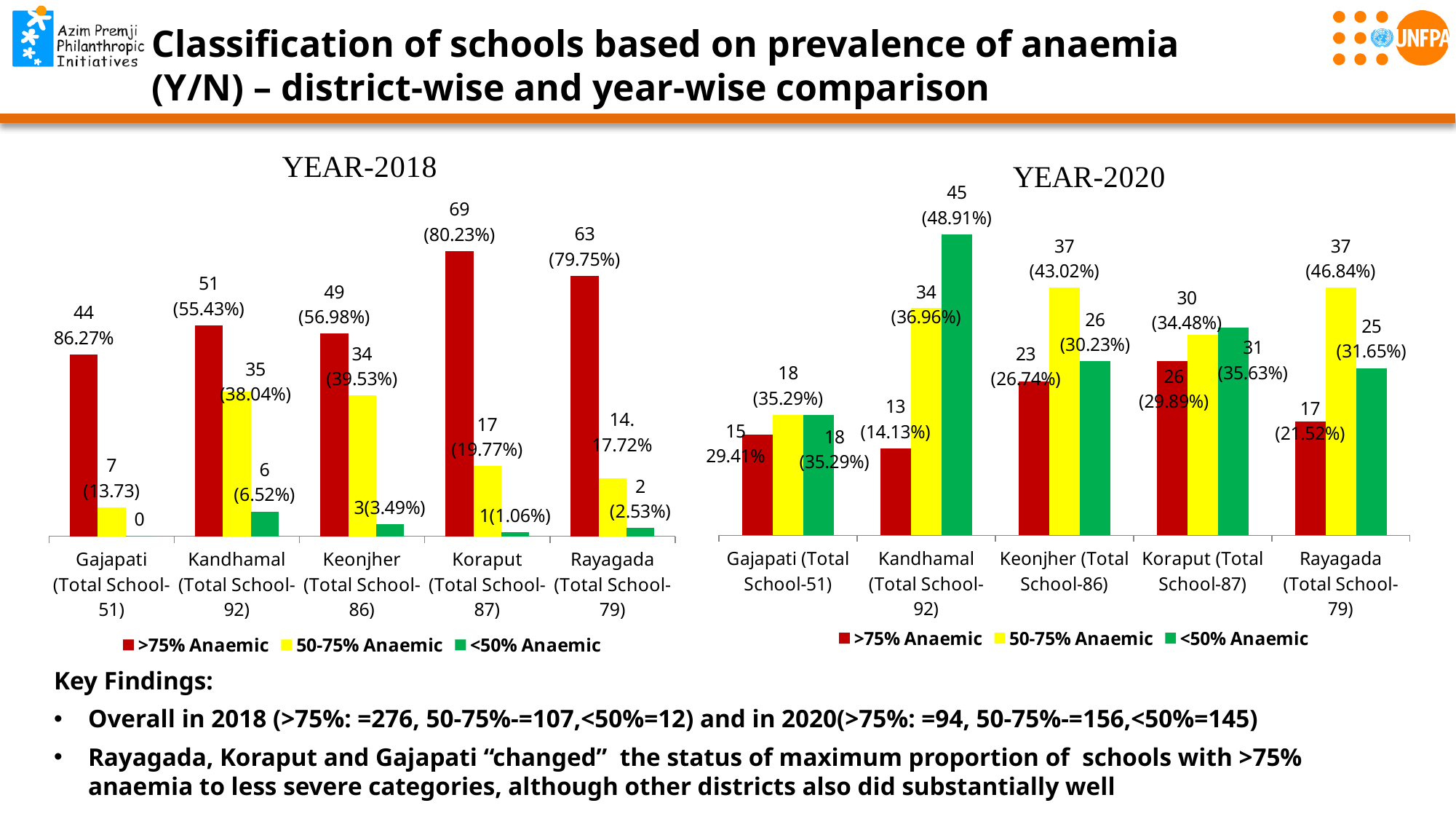
In the YEAR-2018 chart, which district has the highest number of schools in the >75% Anaemic category? Koraput Which colour represents the <50% Anaemic series in the legends of both charts? Green In the YEAR-2018 chart, what percentage is shown for Gajapati in the >75% Anaemic category? 86.27% In the YEAR-2020 chart, what is the total number of schools across the three categories for Rayagada? 79 In the YEAR-2020 chart, how many schools in Kandhamal are in the <50% Anaemic category? 45 In the YEAR-2018 chart, how many schools in Koraput are in the >75% Anaemic category? 69 In the YEAR-2018 chart, what is the difference between the >75% Anaemic and 50-75% Anaemic school counts for Kandhamal? 16 What type of chart is the YEAR-2018 chart? Bar chart In the YEAR-2020 chart, which district has the lowest number of schools in the >75% Anaemic category? Kandhamal How many districts are shown on the x axis of the YEAR-2020 chart? 5 In the YEAR-2020 chart, which is larger for Keonjher: the 50-75% Anaemic count or the <50% Anaemic count? 50-75% Anaemic How many series does the legend of the YEAR-2018 chart list? 3